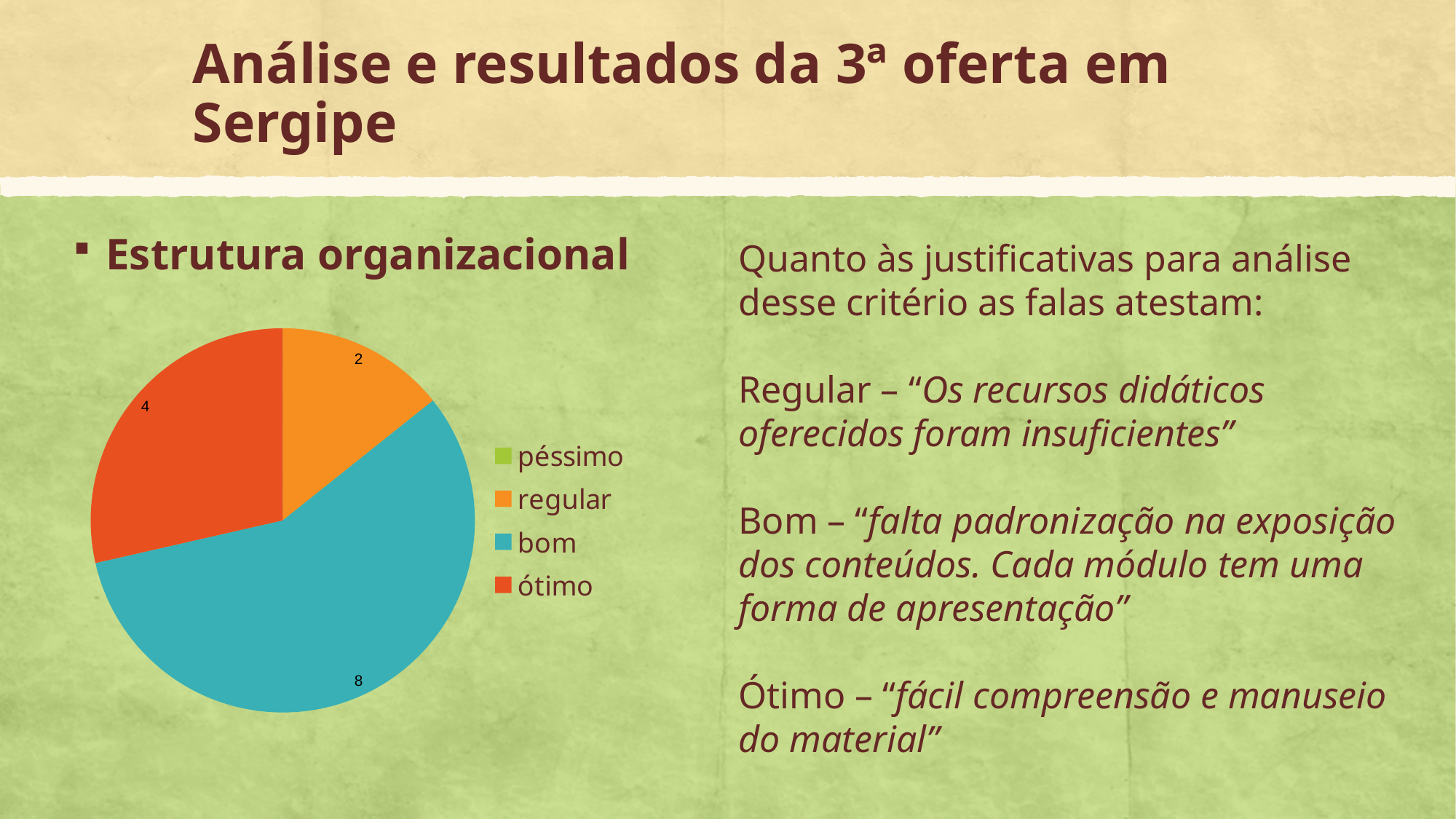
What is the difference between the values for "ótimo" and "regular"? 2 Which category has the largest slice in the pie chart? bom What value is shown for the "regular" slice of the pie chart? 2 What colour is the "bom" slice in the pie chart? blue How many categories does the chart's legend list? 4 What kind of chart is shown on the slide? pie chart What is the difference between the values for "bom" and "ótimo"? 4 What value is shown for the "ótimo" slice of the pie chart? 4 Which is larger, the value for "bom" or the value for "ótimo"? bom Of the slices with a printed value, which category has the smallest? regular What value is shown for the "bom" slice of the pie chart? 8 Which is larger, the value for "regular" or the value for "ótimo"? ótimo